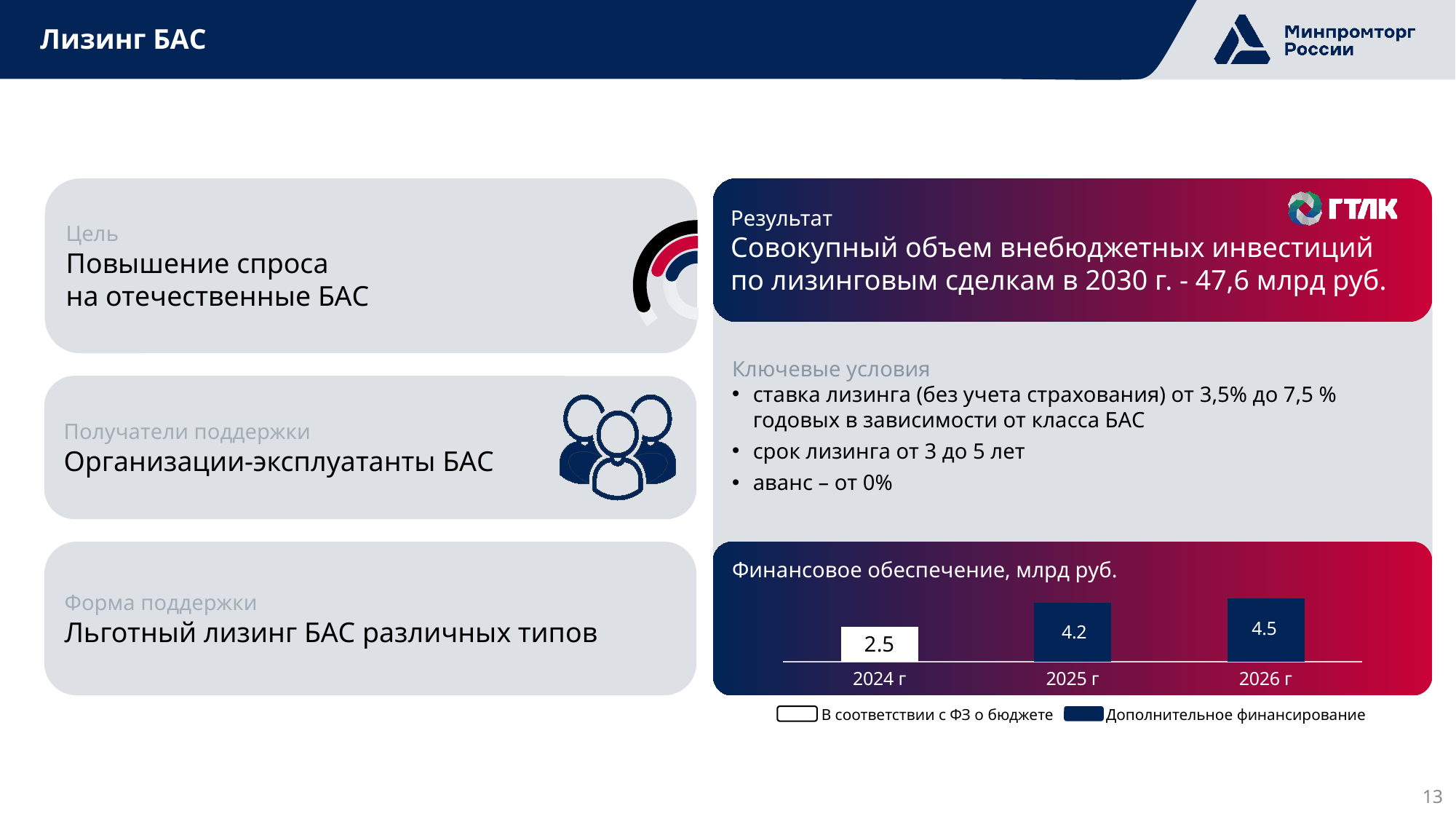
Do the values in the chart 'Финансовое обеспечение, млрд руб.' rise or fall from 2024 г to 2026 г? rise What kind of chart is 'Финансовое обеспечение, млрд руб.'? bar chart Which year has the lowest value in the chart 'Финансовое обеспечение, млрд руб.'? 2024 г What is the value for 2024 г in the chart 'Финансовое обеспечение, млрд руб.'? 2.5 What is the difference between the values for 2026 г and 2024 г in the chart 'Финансовое обеспечение, млрд руб.'? 2.0 What is the value for 2025 г in the chart 'Финансовое обеспечение, млрд руб.'? 4.2 What is the value for 2026 г in the chart 'Финансовое обеспечение, млрд руб.'? 4.5 Which year has the highest value in the chart 'Финансовое обеспечение, млрд руб.'? 2026 г How many years are shown in the chart 'Финансовое обеспечение, млрд руб.'? 3 What is the difference between the values for 2025 г and 2024 г in the chart 'Финансовое обеспечение, млрд руб.'? 1.7 In the chart 'Финансовое обеспечение, млрд руб.', which is larger: the value for 2025 г or 2024 г? 2025 г How many entries does the legend of the chart 'Финансовое обеспечение, млрд руб.' list? 2